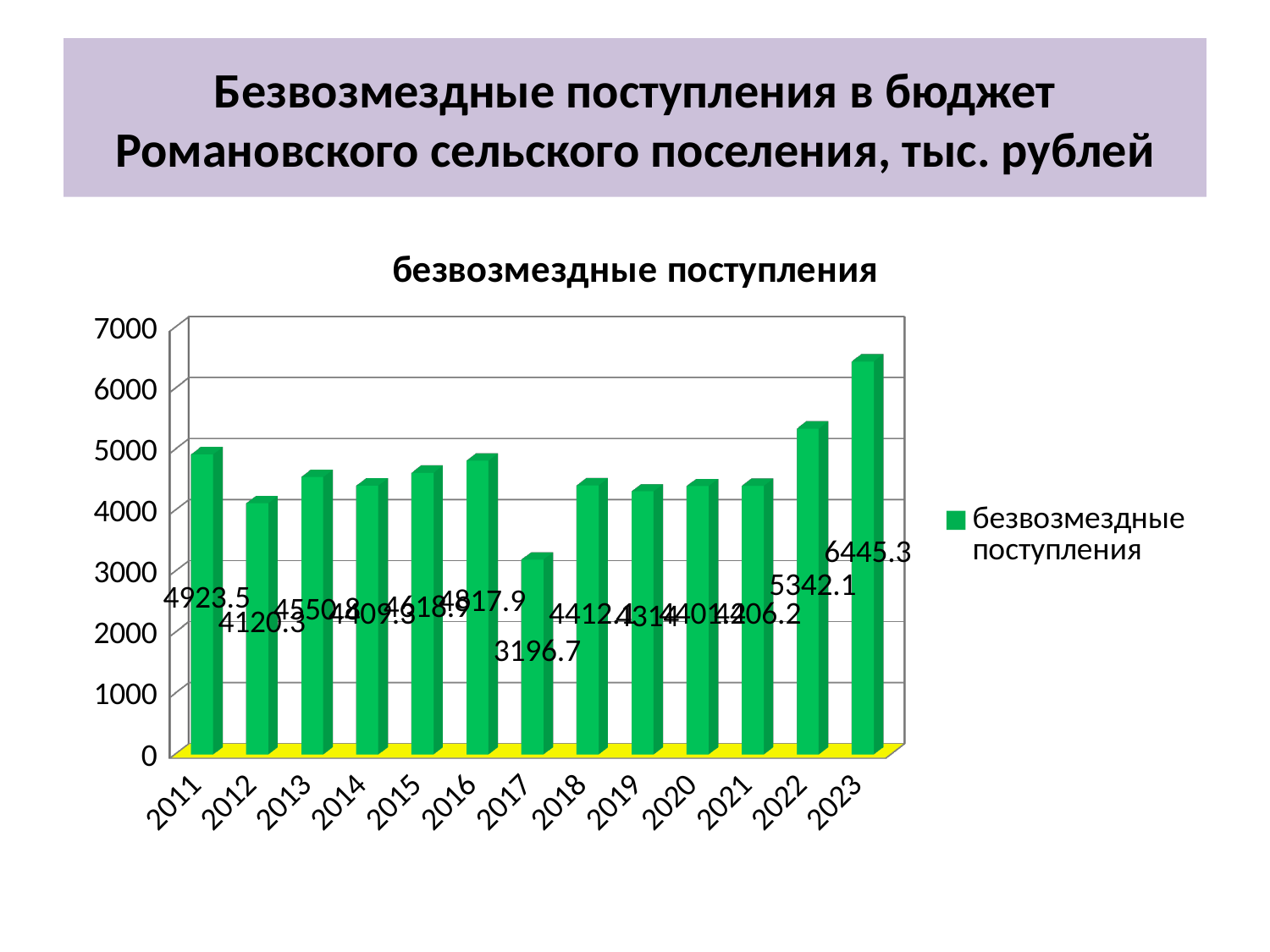
What kind of chart is shown on the slide? bar chart What is the value for 2011? 4923.5 What is the value for 2023? 6445.3 What is the difference between the values for 2011 and 2012? 803.2 How many years are shown on the x axis? 13 What is the value for 2022? 5342.1 Is the value for 2013 greater or less than 4000? greater Which year has the highest value? 2023 What is the difference between the values for 2023 and 2022? 1103.2 Which is larger, the value for 2011 or the value for 2016? 2011 Which year has the lowest value? 2017 What is the value for 2017? 3196.7